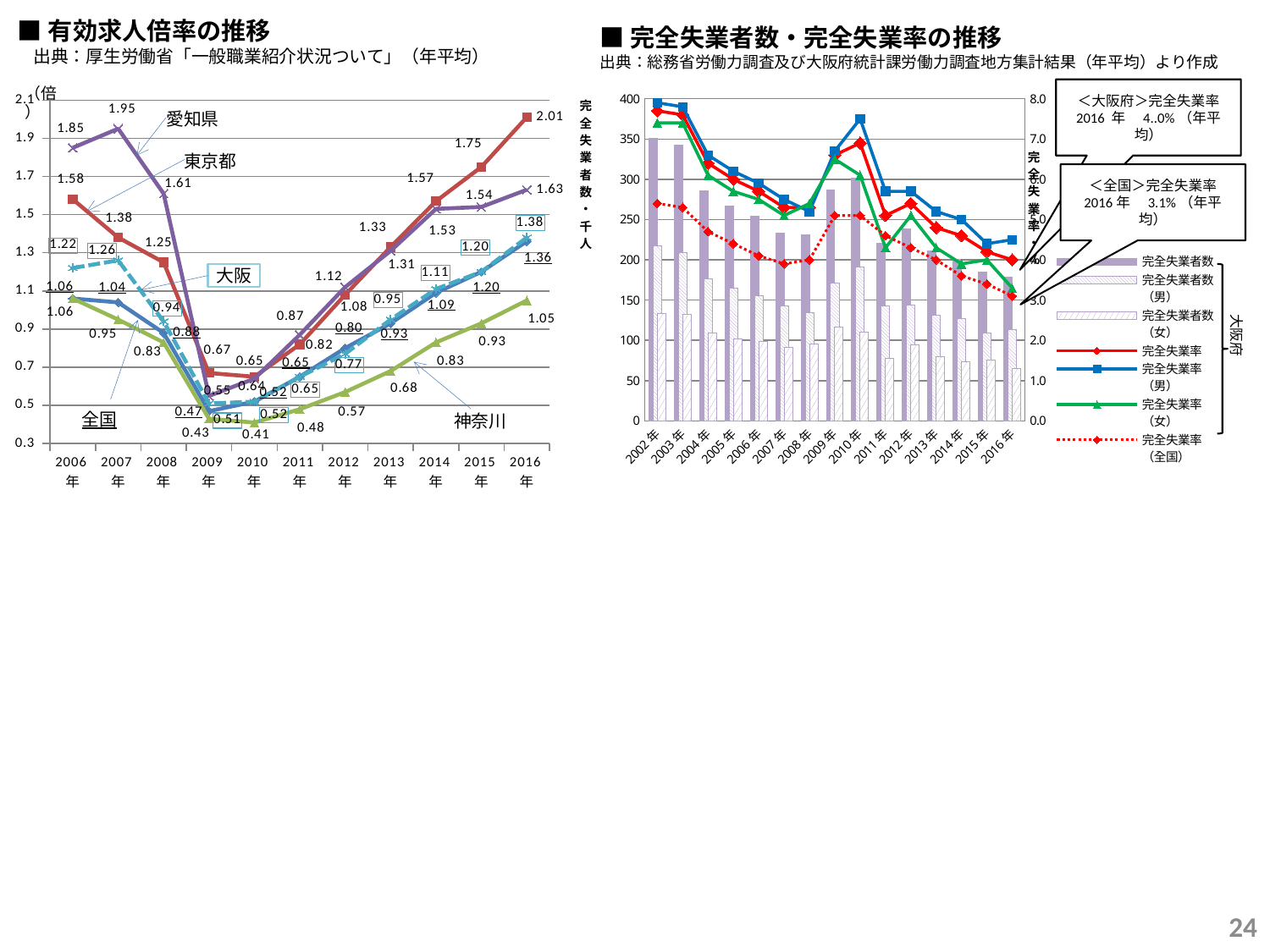
In the right chart (完全失業者数・完全失業率の推移), how many series does the legend list? 7 In the left chart (有効求人倍率の推移), which series has the highest value in 2016年? 東京都 In the left chart (有効求人倍率の推移), what is the value for 愛知県 in 2007年? 1.95 In the left chart (有効求人倍率の推移), what is the value for 大阪 in 2009年? 0.51 In the right chart (完全失業者数・完全失業率の推移), is the 完全失業者数 bar for 2002年 greater or less than 300? greater In the left chart (有効求人倍率の推移), what is the difference between the 東京都 values for 2016年 and 2006年? 0.43 In the left chart (有効求人倍率の推移), what is the value for 東京都 in 2016年? 2.01 What kind of chart is the left chart (有効求人倍率の推移)? line chart In the left chart (有効求人倍率の推移), which series has the lowest value in 2016年? 神奈川 In the left chart (有効求人倍率の推移), which is larger in 2014年, the value for 大阪 or the value for 全国? 大阪 In the left chart (有効求人倍率の推移), how many years are shown on the x axis? 11 In the left chart (有効求人倍率の推移), does the 神奈川 series rise or fall from 2010年 to 2016年? rise